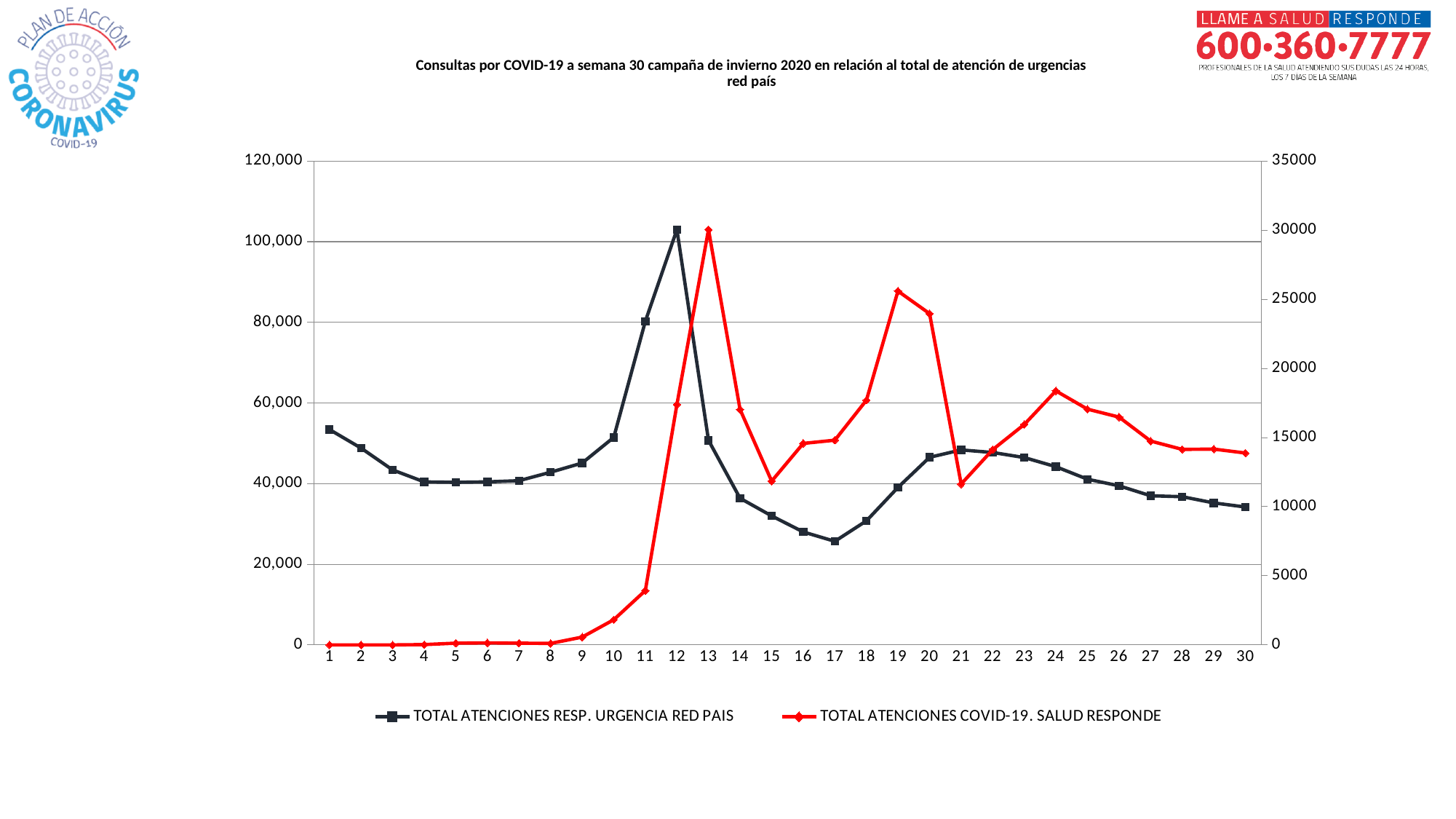
How many series does the legend list? 2 Is the value for TOTAL ATENCIONES RESP. URGENCIA RED PAIS in week 17 greater or less than 40,000? less In which week does the TOTAL ATENCIONES RESP. URGENCIA RED PAIS series reach its lowest value? 17 Is the value for TOTAL ATENCIONES COVID-19. SALUD RESPONDE in week 13 greater or less than 25000 on the right axis? greater Which is larger for TOTAL ATENCIONES RESP. URGENCIA RED PAIS: the value in week 1 or the value in week 30? week 1 Does the TOTAL ATENCIONES COVID-19. SALUD RESPONDE series rise or fall between week 8 and week 13? rise What kind of chart is shown on the slide? line chart How many weeks are plotted along the x axis? 30 In which week does the TOTAL ATENCIONES RESP. URGENCIA RED PAIS series reach its highest value? 12 In which week does the TOTAL ATENCIONES COVID-19. SALUD RESPONDE series reach its highest value? 13 Is the value for TOTAL ATENCIONES COVID-19. SALUD RESPONDE in week 24 greater or less than 20000 on the right axis? less